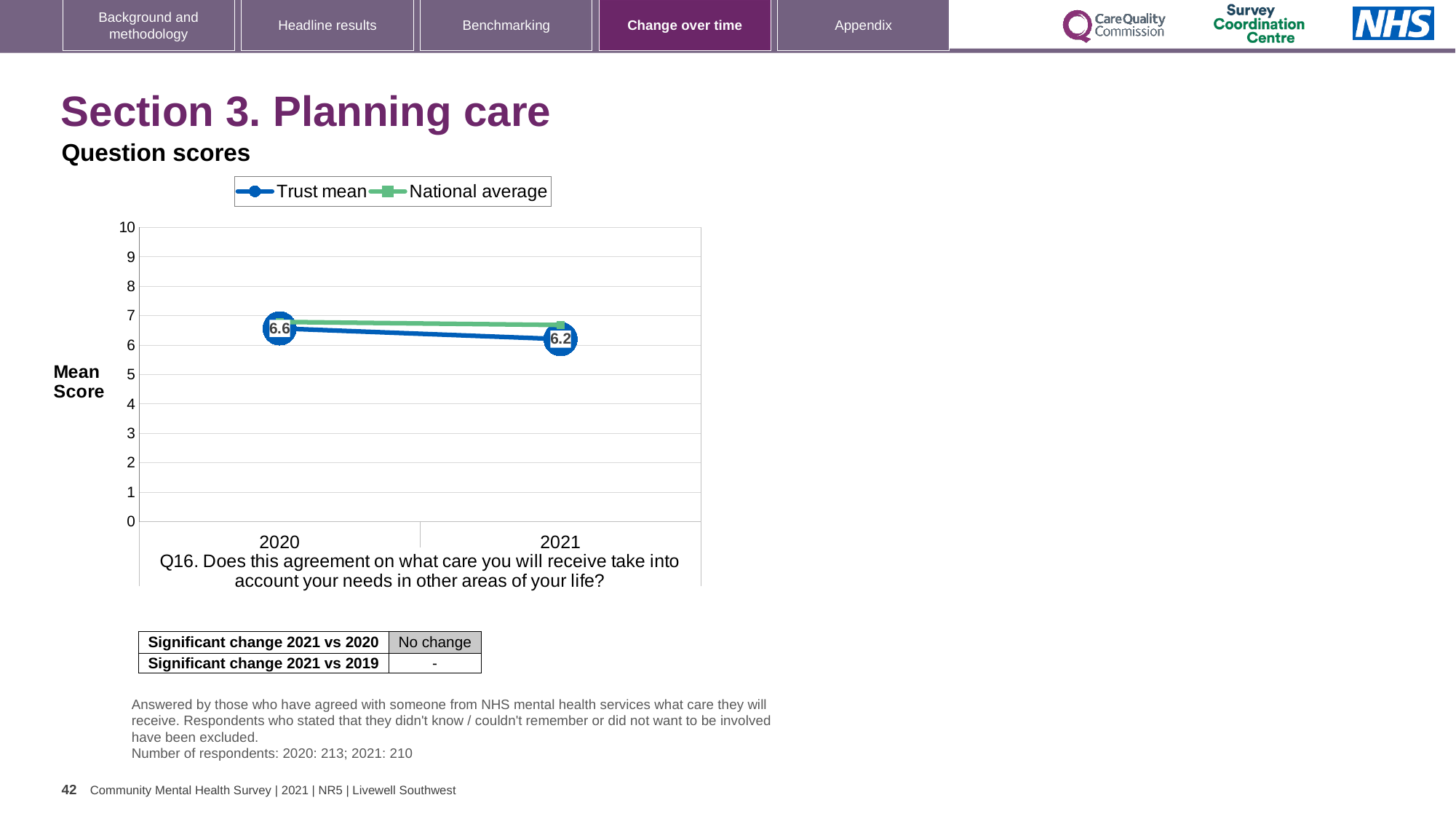
What is the Trust mean score for 2020? 6.6 Is the National average value for 2020 greater or less than 6? greater What kind of chart is shown on the slide? Line chart How many years are plotted on the x axis? 2 By how much did the Trust mean score change from 2020 to 2021? 0.4 Does the Trust mean rise or fall from 2020 to 2021? Fall In which year is the Trust mean score lowest? 2021 In 2021, which is larger: the Trust mean or the National average? National average In which year is the Trust mean score highest? 2020 What is the Trust mean score for 2021? 6.2 Is the National average value for 2021 greater or less than 7? less How many series does the legend list? 2